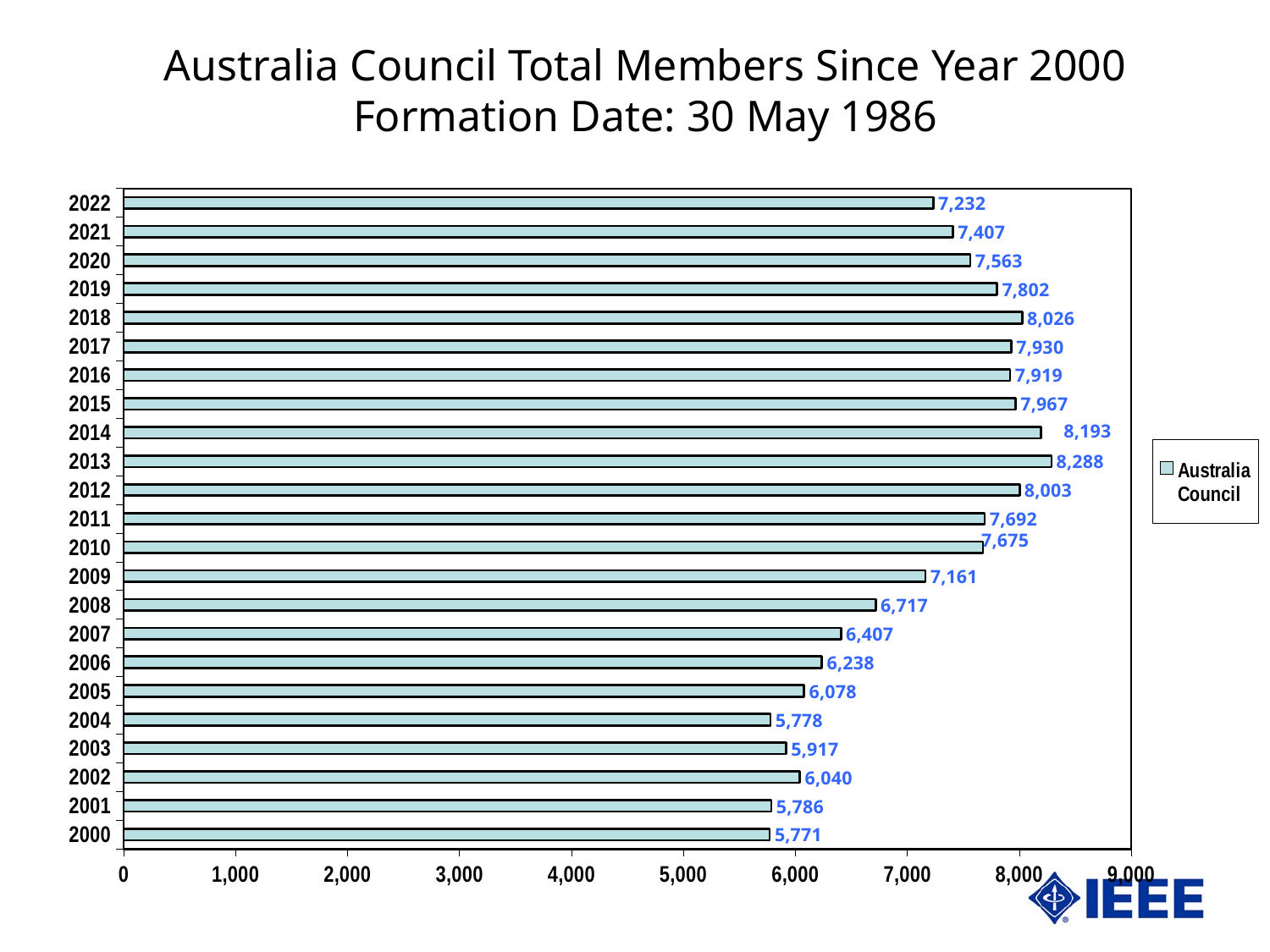
Which year had more members, 2009 or 2010? 2010 What is the difference in membership between 2018 and 2022? 794 What is the difference in membership between 2013 and 2000? 2,517 What was the total membership of the Australia Council in 2013? 8,288 Which year had the highest total membership? 2013 How many years are shown on the chart? 23 What kind of chart is shown on the slide? Bar chart What was the total membership of the Australia Council in 2022? 7,232 What was the total membership of the Australia Council in 2000? 5,771 What series name does the legend list? Australia Council Is the value for 2014 greater or less than 8,000? greater Which year had the lowest total membership? 2000